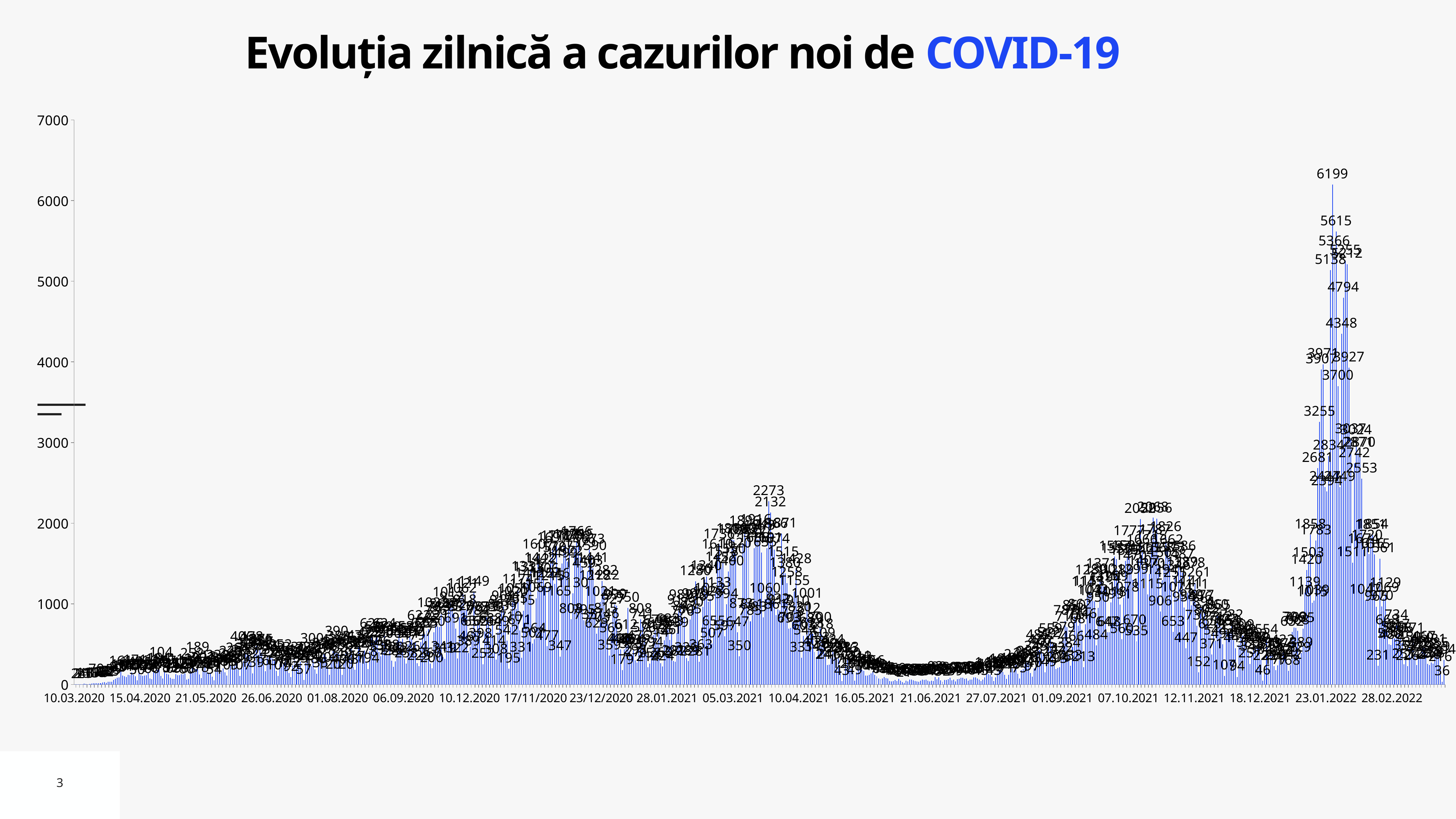
What is the highest value labelled in the March 2021 wave (around 05.03.2021)? 2273 What is the first date label on the horizontal axis? 10.03.2020 What is the highest daily value labelled on the chart? 6199 What is the difference between the two highest labelled values, 6199 and 5615? 584 What is the highest tick value shown on the vertical axis? 7000 Is the highest bar of the December 2020 wave greater or less than 2000? less What is the difference between the overall peak value (6199) and the March 2021 peak (2273)? 3926 Which is larger: the peak of the early 2022 wave or the peak of the March 2021 wave? the early 2022 wave What kind of chart is shown on the slide? bar chart What is the title of the chart? Evoluția zilnică a cazurilor noi de COVID-19 Is the highest bar of the autumn 2021 wave (around 07.10.2021) greater or less than 3000? less